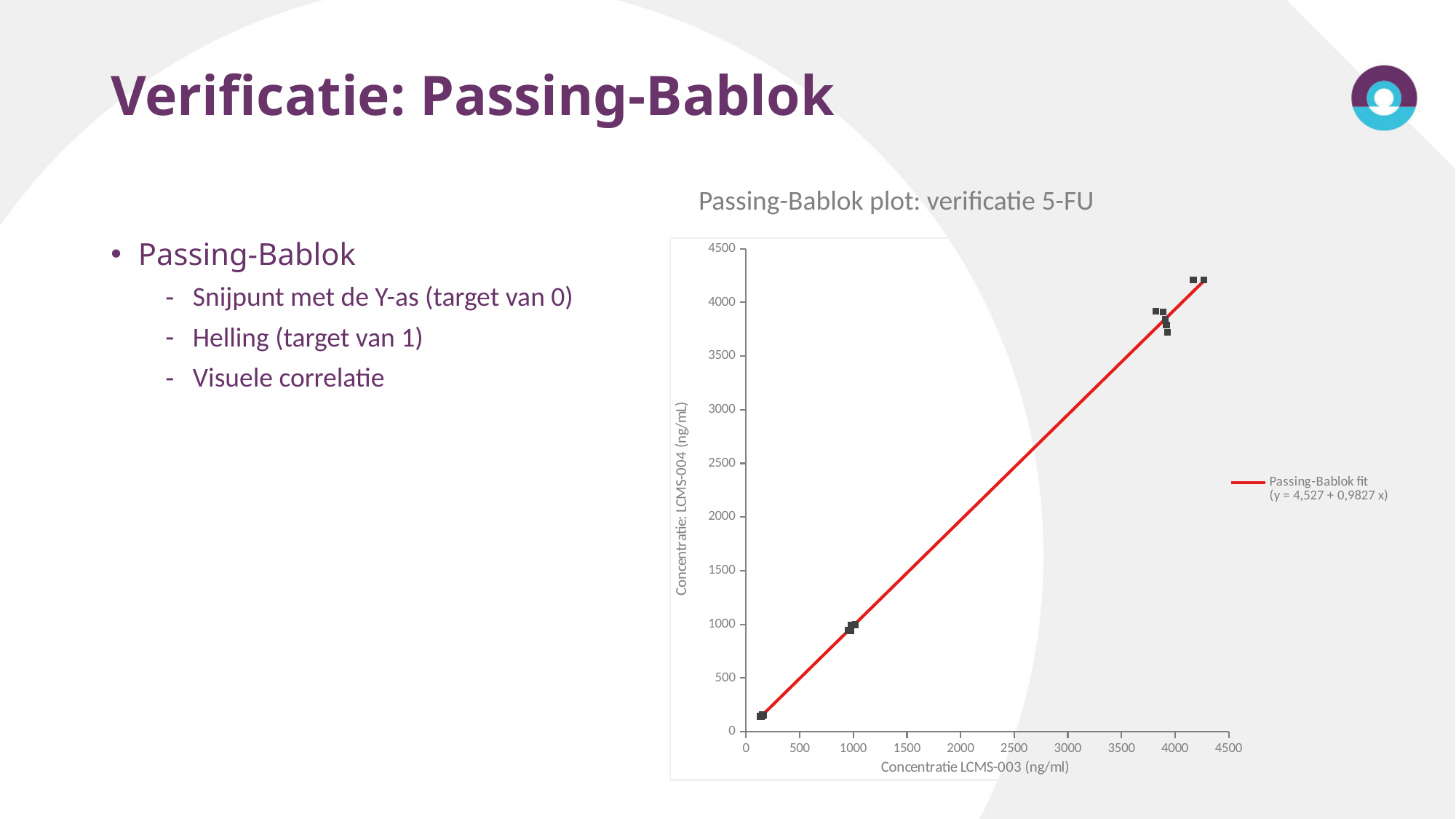
What is the title of the chart? Passing-Bablok plot: verificatie 5-FU What is the label of the x-axis? Concentratie LCMS-003 (ng/ml) Do the plotted points rise or fall as the x-axis value increases? Rise What is the maximum value shown on the x-axis? 4500 Are the lowest plotted points greater or less than 500 on the y-axis? less What is the intercept of the Passing-Bablok fit shown in the legend? 4,527 What kind of chart is shown on the slide? Scatter plot How many entries does the chart legend list? 1 What is the slope of the Passing-Bablok fit shown in the legend? 0,9827 What is the label of the y-axis? Concentratie: LCMS-004 (ng/mL) Are the highest plotted points greater or less than 4000 on the y-axis? greater What equation is given for the Passing-Bablok fit in the legend? y = 4,527 + 0,9827 x